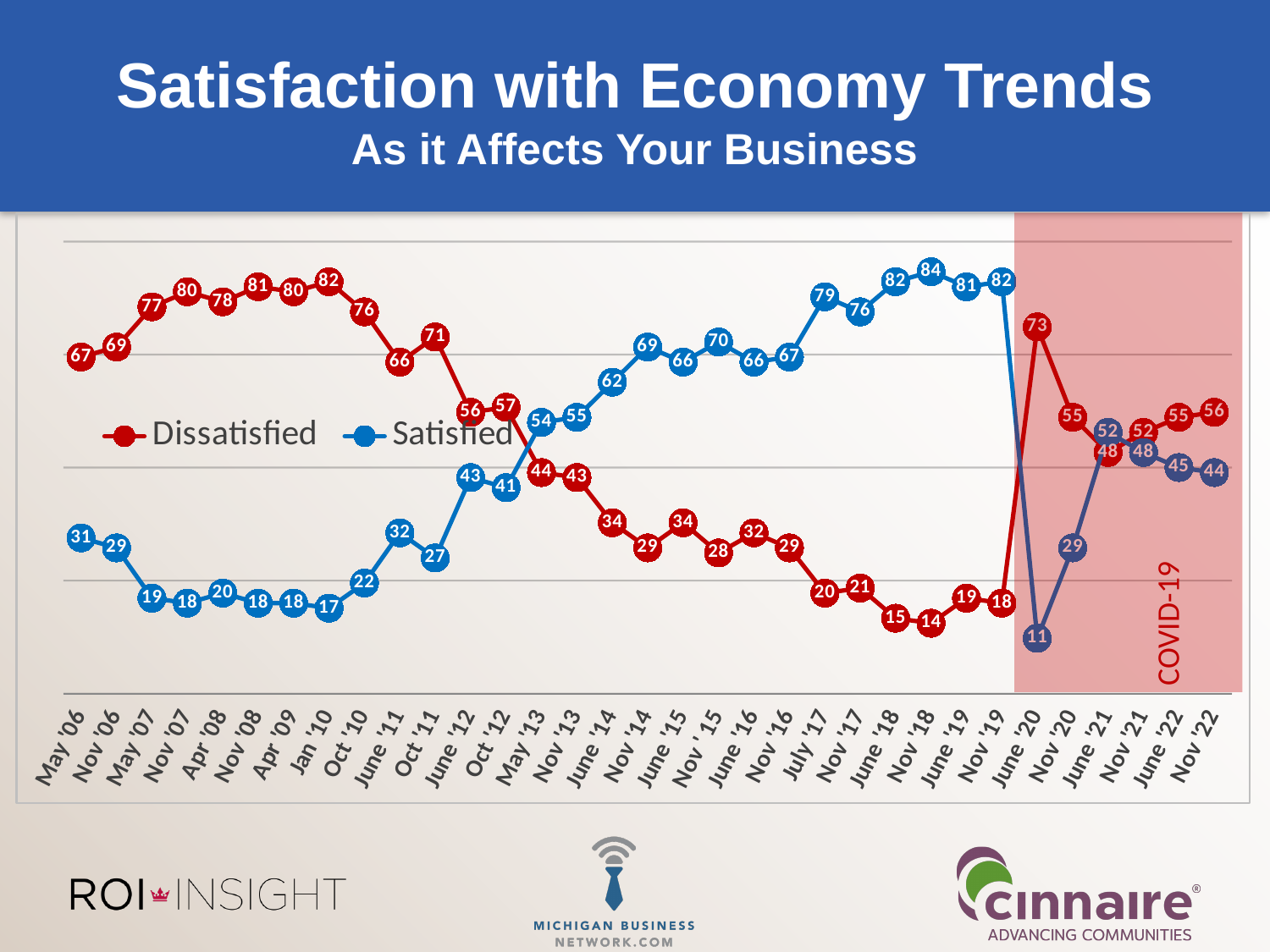
What is the Satisfied value for June '20? 11 In which period does the Dissatisfied series reach its lowest value? Nov '18 What is the difference between the Dissatisfied and Satisfied values in Nov '22? 12 Which series has the larger value in June '21, Dissatisfied or Satisfied? Satisfied What is the Satisfied value for Nov '22? 44 What label appears in the shaded region on the right side of the chart? COVID-19 Does the Satisfied series rise or fall between Nov '19 and June '20? fall What type of chart is shown on the slide? line chart In which period does the Satisfied series reach its highest value? Nov '18 How many series does the legend list? 2 What is the Dissatisfied value for June '20? 73 How many time periods are plotted along the x axis? 33